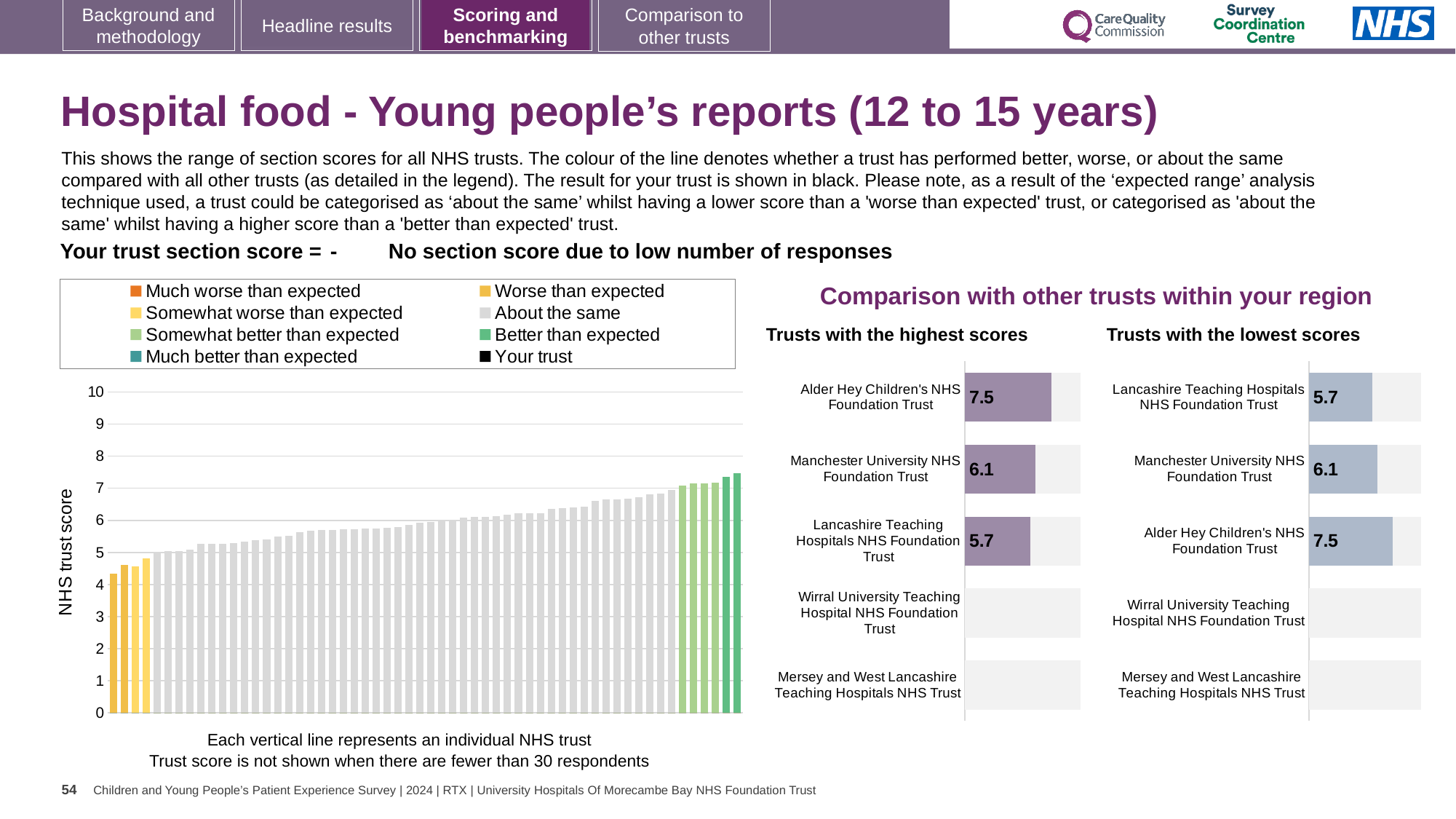
In the 'Trusts with the highest scores' chart, what is the difference between the scores of Alder Hey Children's NHS Foundation Trust and Lancashire Teaching Hospitals NHS Foundation Trust? 1.8 In the 'Trusts with the highest scores' chart, what is the score for Manchester University NHS Foundation Trust? 6.1 In the 'Trusts with the lowest scores' chart, what is the difference between the scores of Alder Hey Children's NHS Foundation Trust and Manchester University NHS Foundation Trust? 1.4 In the 'Trusts with the highest scores' chart, which has the larger score: Manchester University NHS Foundation Trust or Lancashire Teaching Hospitals NHS Foundation Trust? Manchester University NHS Foundation Trust How many trusts are listed in the 'Trusts with the highest scores' chart? 5 In the 'Trusts with the lowest scores' chart, what is the score for Lancashire Teaching Hospitals NHS Foundation Trust? 5.7 What kind of chart is the 'NHS trust score' chart on the left of the slide? Bar chart In the 'NHS trust score' chart, do the bar values rise or fall from left to right? Rise In the 'Trusts with the highest scores' chart, what is the score for Alder Hey Children's NHS Foundation Trust? 7.5 How many entries does the legend above the 'NHS trust score' chart list? 8 In the 'Trusts with the highest scores' chart, which trust has the highest score? Alder Hey Children's NHS Foundation Trust In the 'Trusts with the lowest scores' chart, which trust has the lowest score? Lancashire Teaching Hospitals NHS Foundation Trust